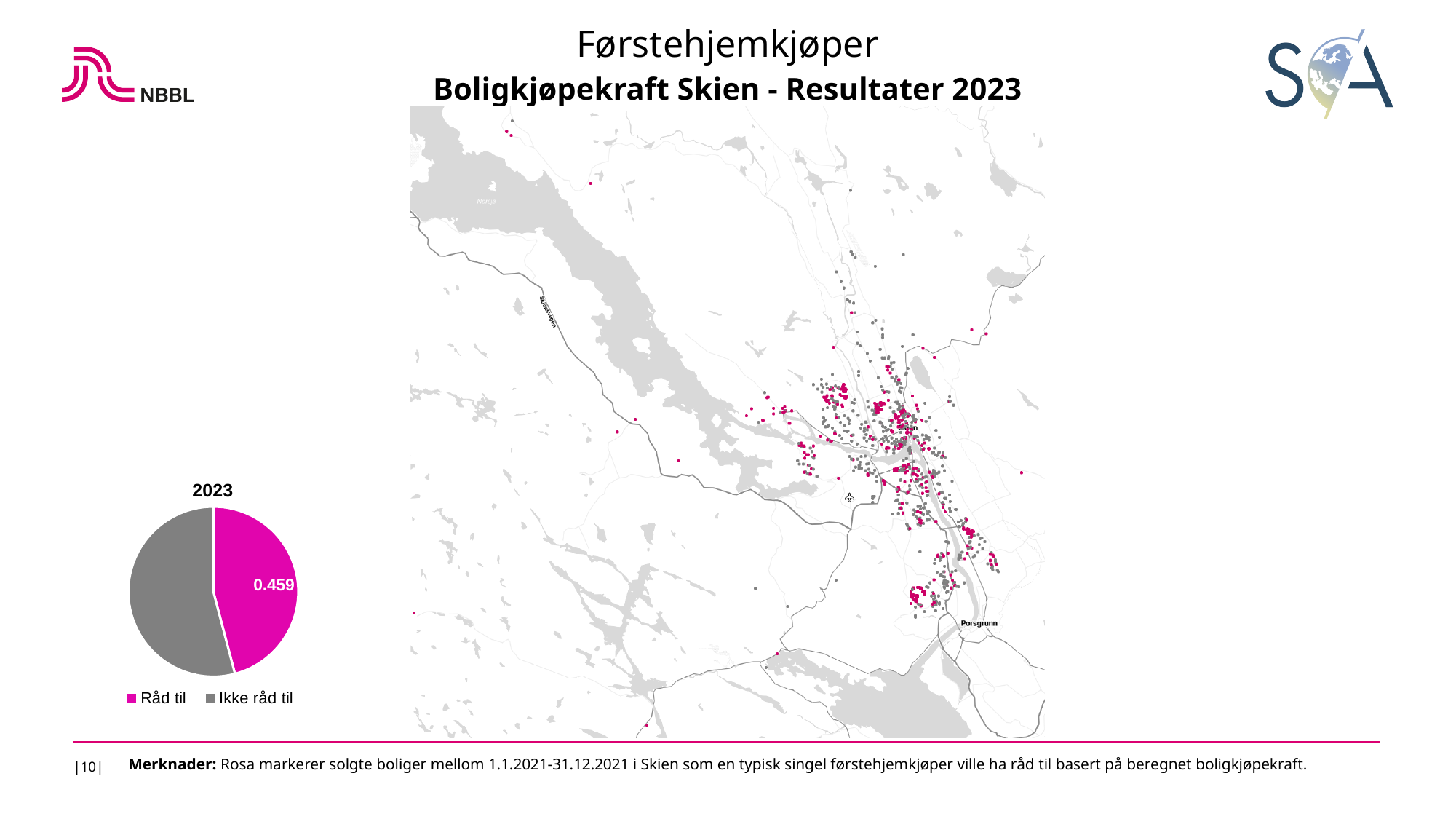
How many entries does the legend of the 2023 pie chart list? 2 What is the title of the pie chart on the left of the slide? 2023 How many slices does the 2023 pie chart have? 2 In the 2023 pie chart, what value is shown for the Råd til slice? 0.459 What colour is the Råd til slice in the 2023 pie chart? pink Which slice is the smallest in the 2023 pie chart? Råd til What kind of chart is the chart titled 2023 on the left of the slide? pie chart In the 2023 pie chart, which slice is larger, Råd til or Ikke råd til? Ikke råd til Which slice is the largest in the 2023 pie chart? Ikke råd til